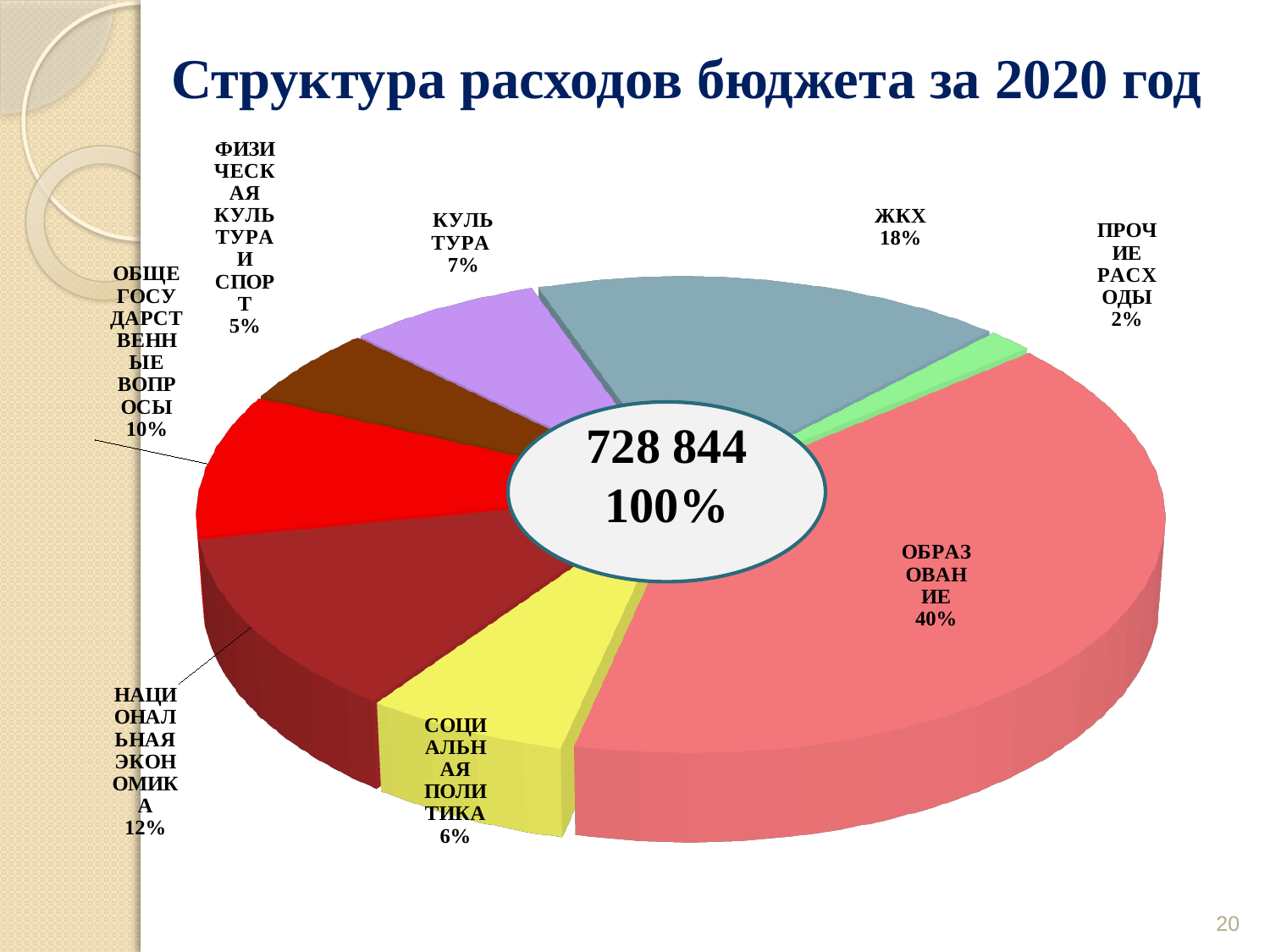
What is the difference in percentage points between Образование and ЖКХ? 22 What share of the budget expenditure goes to Образование? 40% Which category has the smallest share of the budget expenditure? Прочие расходы Which has a larger share, Культура or Социальная политика? Культура Which category has the largest share of the budget expenditure? Образование What kind of chart is shown on the slide? Pie chart What is the title of the chart? Структура расходов бюджета за 2020 год How many categories are shown in the pie chart? 8 What share of the budget expenditure goes to ЖКХ? 18% What share of the budget expenditure goes to Национальная экономика? 12% What total value is shown in the centre of the pie chart? 728 844